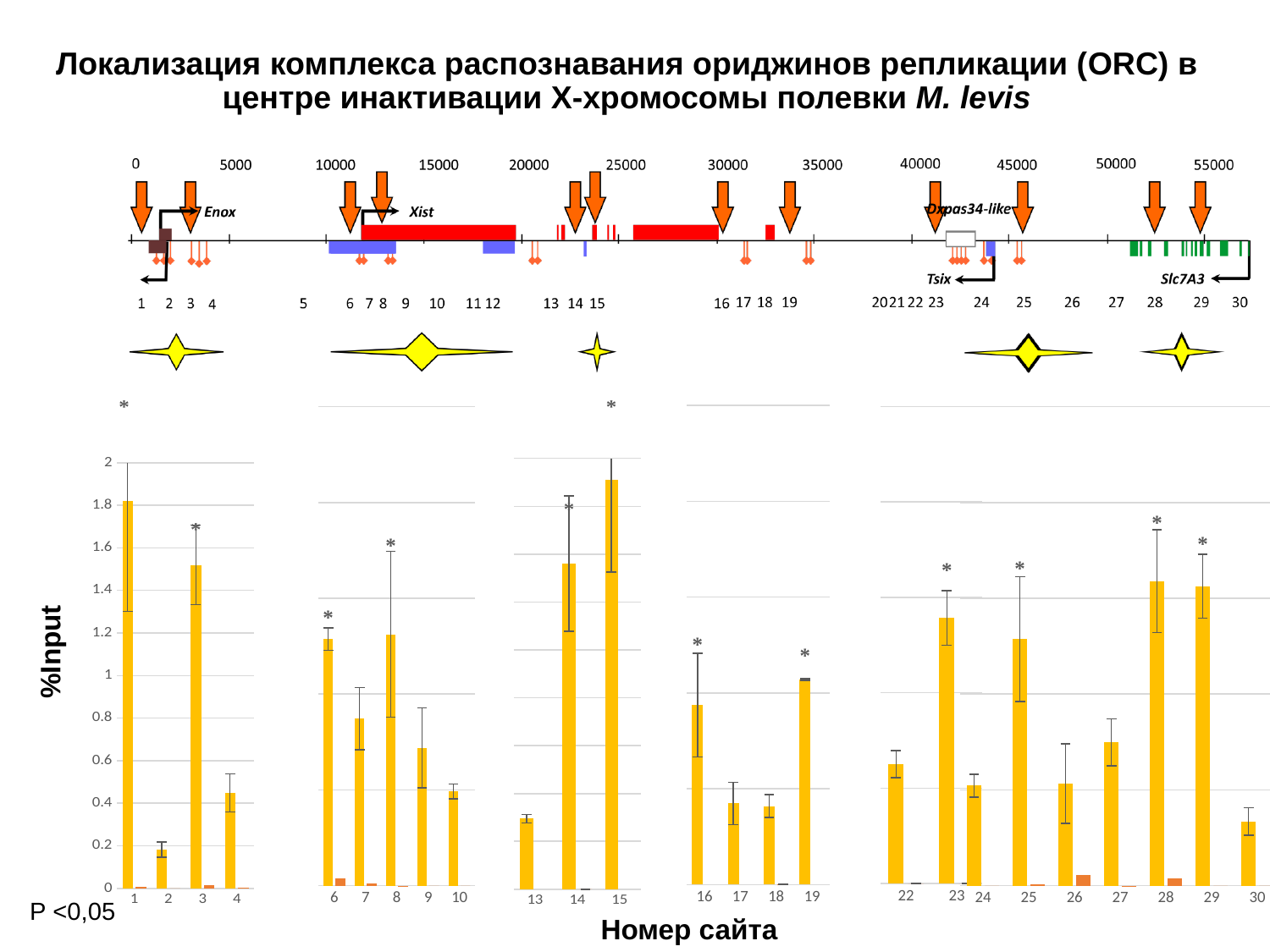
Which site has the larger %Input value, site 3 or site 4? 3 Is the %Input value for site 2 greater or less than 0.4? less How many site numbers are shown along the x axis of the chart? 25 What kind of chart is shown on the slide? bar chart Which site has the larger %Input value, site 13 or site 14? 14 Which site has the lowest %Input value in the chart? 2 What is the label of the x axis of the chart? Номер сайта Is the %Input value for site 9 greater or less than 0.8? less Is the %Input value for site 14 greater or less than 1.4? greater What is the label of the y axis of the chart? %Input